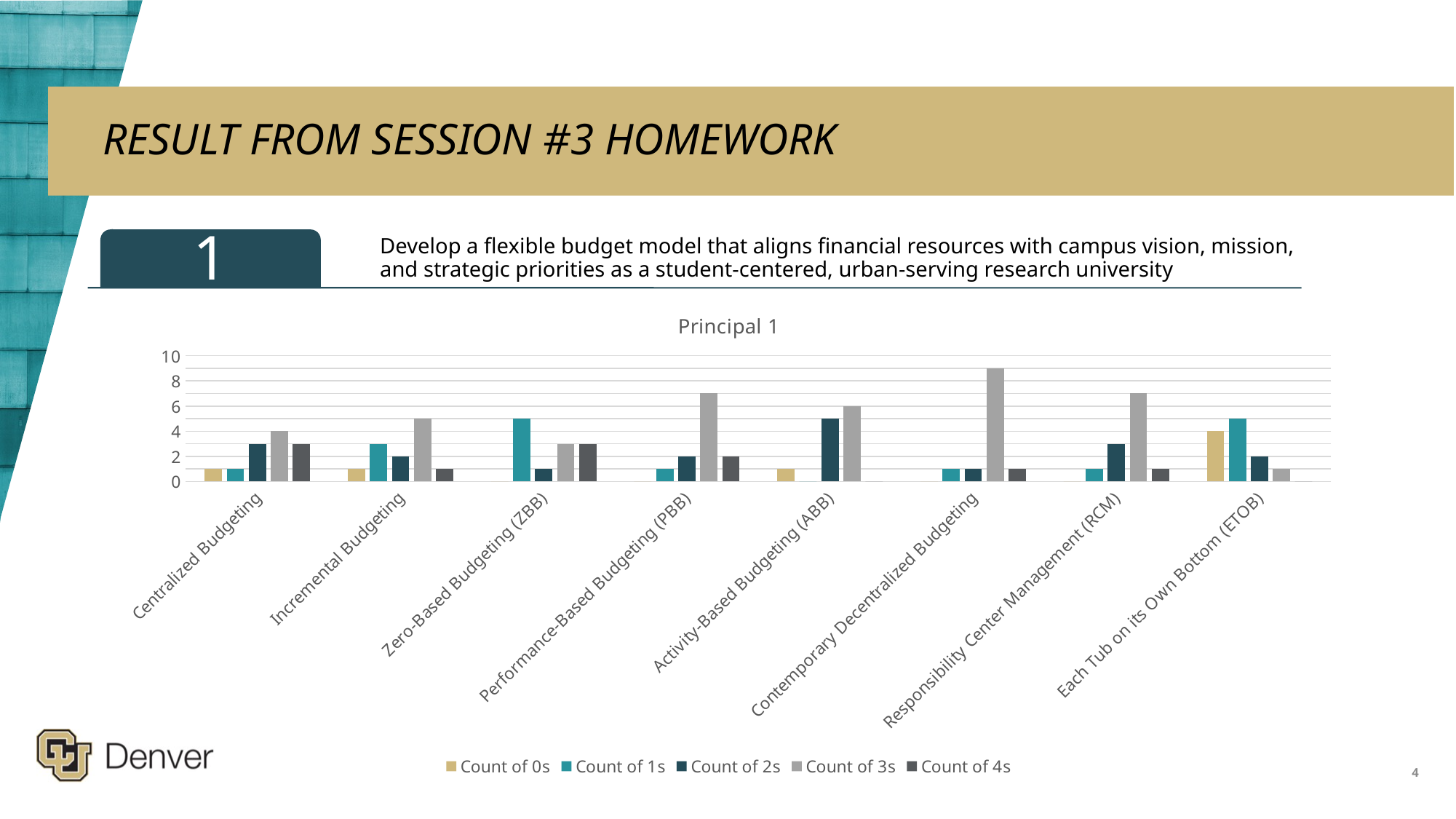
How many budgeting model categories are shown on the x axis? 8 Which series is shown in light grey in the legend? Count of 3s What kind of chart is shown on the slide? bar chart Which category has the tallest bar for Count of 3s? Contemporary Decentralized Budgeting What is the Count of 0s value for Each Tub on its Own Bottom (ETOB)? 4 How many series does the legend list? 5 What is the title of the chart? Principal 1 What is the Count of 3s value for Centralized Budgeting? 4 Is the Count of 3s value for Contemporary Decentralized Budgeting greater or less than 8? greater Is the Count of 3s value for Performance-Based Budgeting (PBB) greater or less than 6? greater Which is larger for Zero-Based Budgeting (ZBB): Count of 1s or Count of 2s? Count of 1s What is the Count of 3s value for Activity-Based Budgeting (ABB)? 6